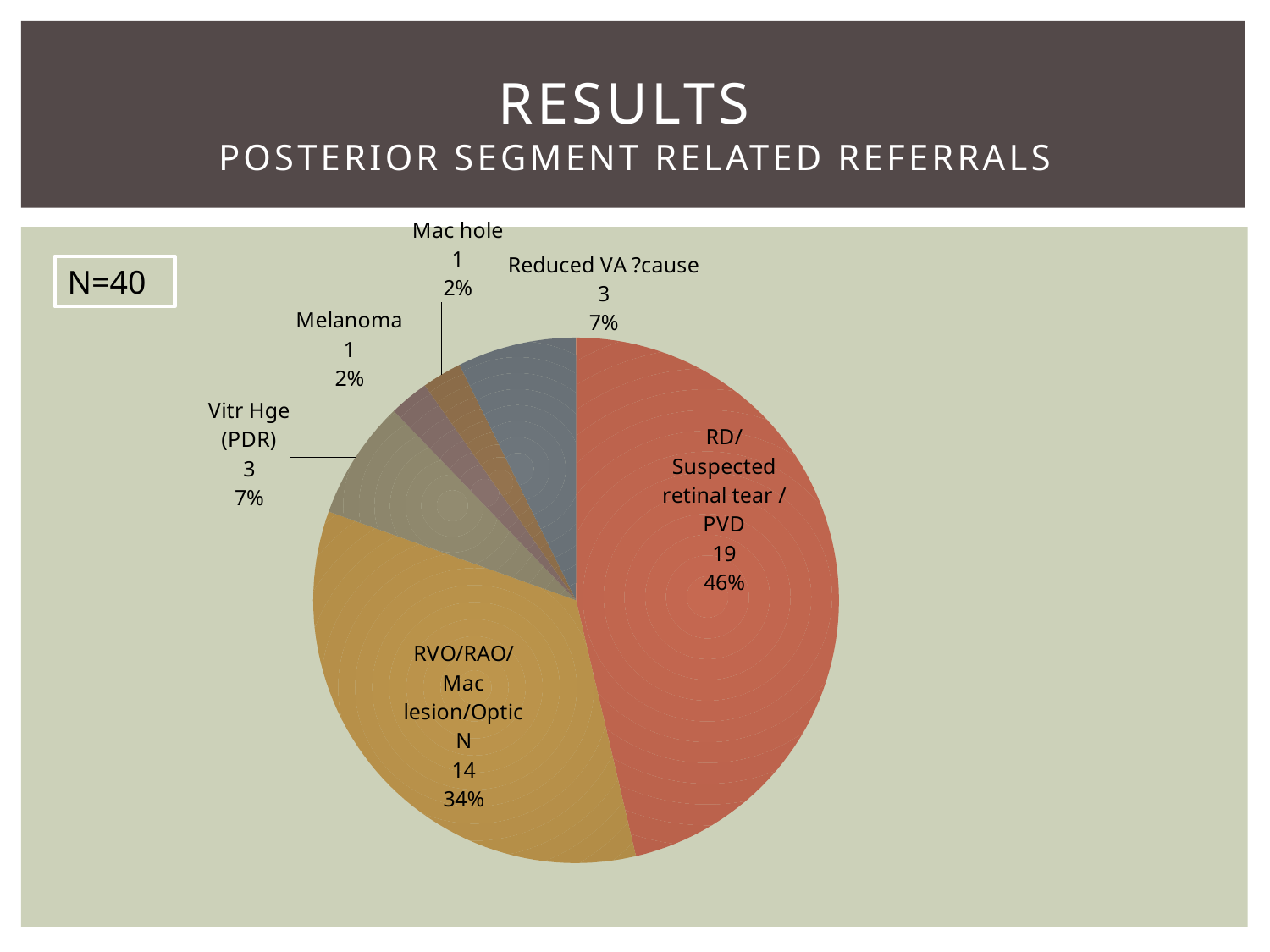
What percentage of referrals does the Mac hole slice represent? 2% Which category has the largest number of referrals? RD/Suspected retinal tear/PVD Which has more referrals, Vitr Hge (PDR) or Mac hole? Vitr Hge (PDR) How many categories are shown in the pie chart? 6 What kind of chart is shown on the slide? pie chart What total N is stated on the slide for the chart? N=40 How many referrals are in the RD/Suspected retinal tear/PVD category? 19 What is the difference in referral count between RD/Suspected retinal tear/PVD and RVO/RAO/Mac lesion/Optic N? 5 How many referrals are in the Melanoma category? 1 What percentage of referrals does the RVO/RAO/Mac lesion/Optic N slice represent? 34% How many referrals are in the Vitr Hge (PDR) category? 3 What percentage of referrals does the Reduced VA ?cause slice represent? 7%